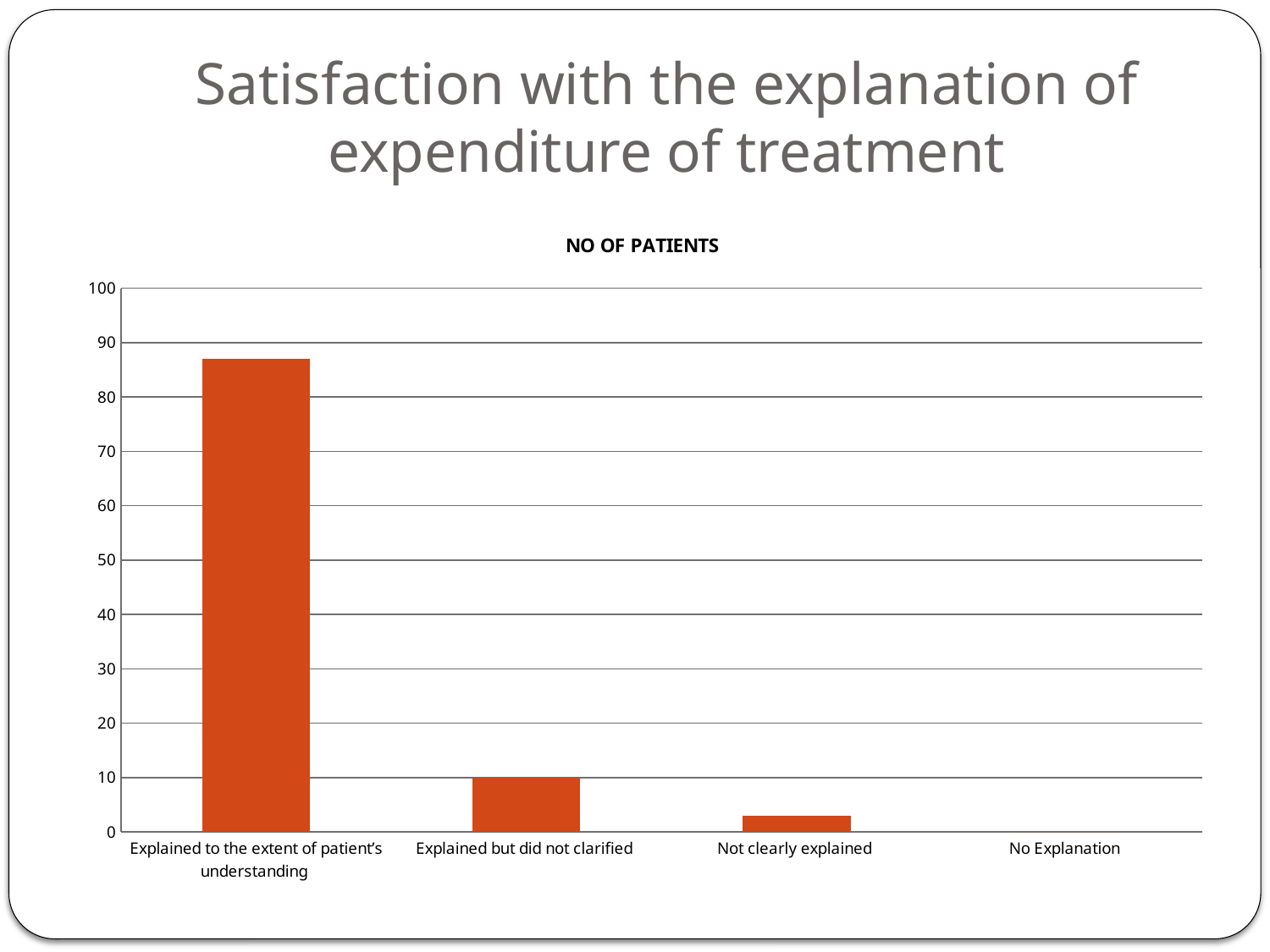
What is the number of patients for 'Explained but did not clarified'? 10 Which is larger: the value for 'Explained but did not clarified' or the value for 'Not clearly explained'? Explained but did not clarified How many categories are shown on the x axis of the chart? 4 Do the values rise or fall moving left to right along the x axis? fall What is the title of the chart? NO OF PATIENTS Is the value for 'Explained to the extent of patient's understanding' greater or less than 90? less Is the value for 'Explained to the extent of patient's understanding' greater or less than 80? greater What is the number of patients for 'No Explanation'? 0 Which category has the lowest number of patients? No Explanation Is the value for 'Not clearly explained' greater or less than 10? less What kind of chart is shown on the slide? bar chart Which category has the highest number of patients? Explained to the extent of patient's understanding